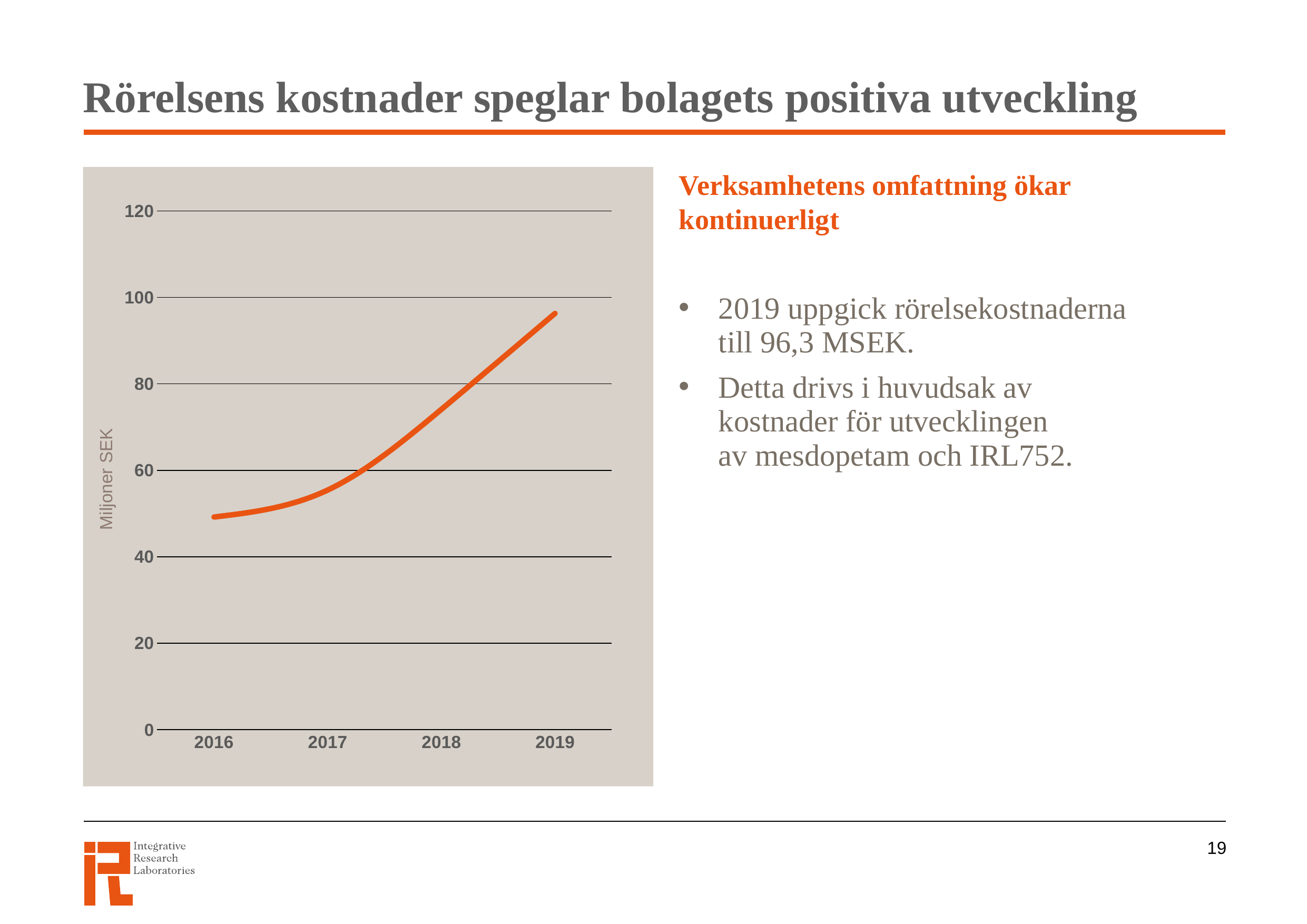
Is the value for 2016 greater or less than 40? greater What is the label on the y axis of the chart? Miljoner SEK How many years are plotted on the x axis of the chart? 4 What kind of chart is shown on the slide? line chart Which year has the lowest value in the chart? 2016 Which year has the larger value, 2017 or 2018? 2018 Is the value for 2019 greater or less than 100? less Is the value for 2016 greater or less than 60? less According to the slide, what were the operating costs (rörelsekostnaderna) in 2019? 96,3 MSEK Do the values in the chart rise or fall from 2016 to 2019? rise Which year has the highest value in the chart? 2019